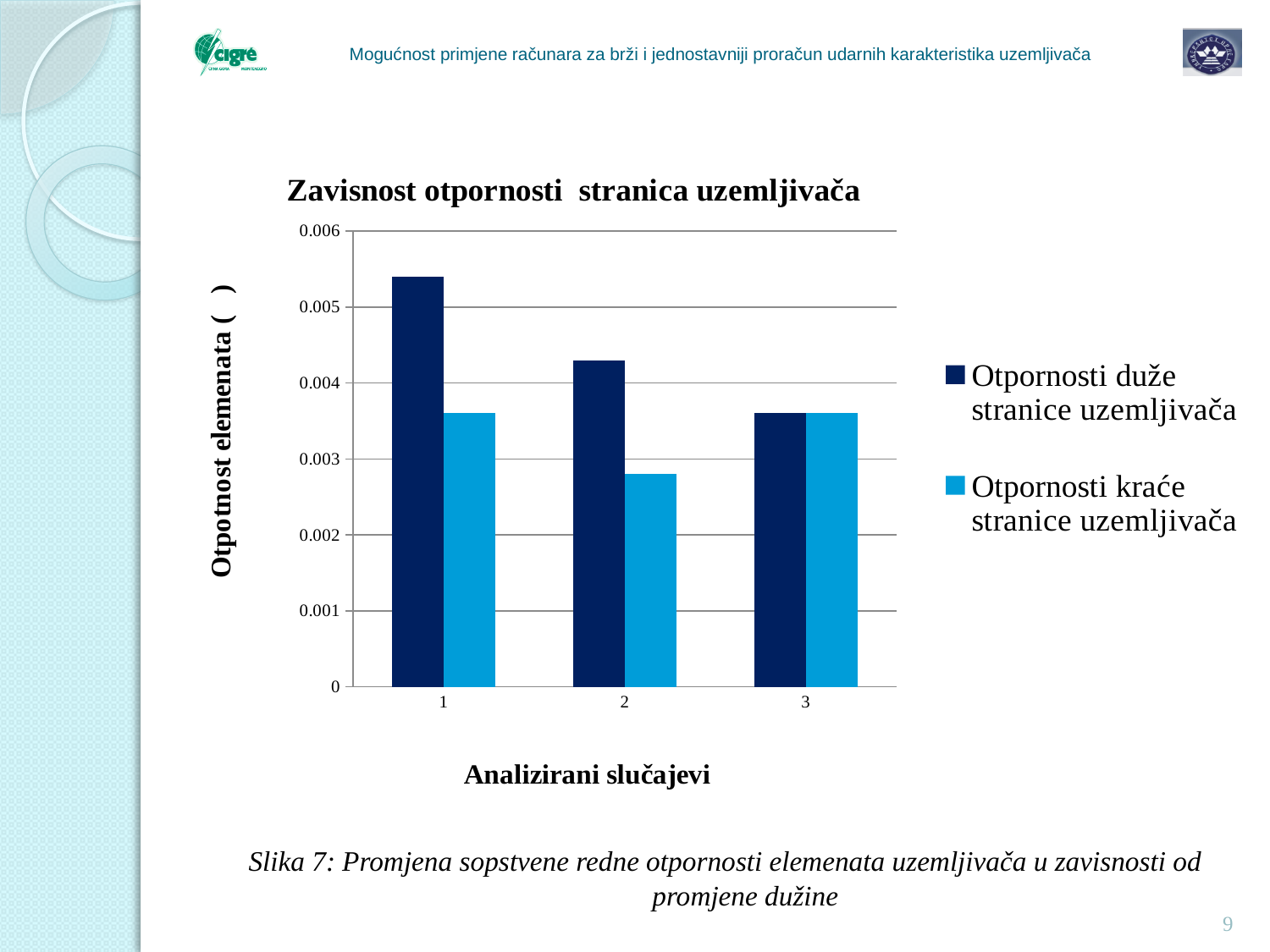
What kind of chart is shown on the slide? bar chart In case 1, which series has the larger value: 'Otpornosti duže stranice uzemljivača' or 'Otpornosti kraće stranice uzemljivača'? Otpornosti duže stranice uzemljivača Is the value for 'Otpornosti duže stranice uzemljivača' in case 1 greater or less than 0.005? greater How many series does the legend list? 2 For which case is the value of 'Otpornosti duže stranice uzemljivača' highest? 1 For which case is the value of 'Otpornosti duže stranice uzemljivača' lowest? 3 What is the title of the chart? Zavisnost otpornosti stranica uzemljivača Is the value for 'Otpornosti kraće stranice uzemljivača' in case 2 greater or less than 0.003? less Do the values of 'Otpornosti duže stranice uzemljivača' rise or fall from case 1 to case 3? fall How many analysed cases (categories) are shown on the x axis? 3 For which case is the value of 'Otpornosti kraće stranice uzemljivača' lowest? 2 What is the x-axis label of the chart? Analizirani slučajevi